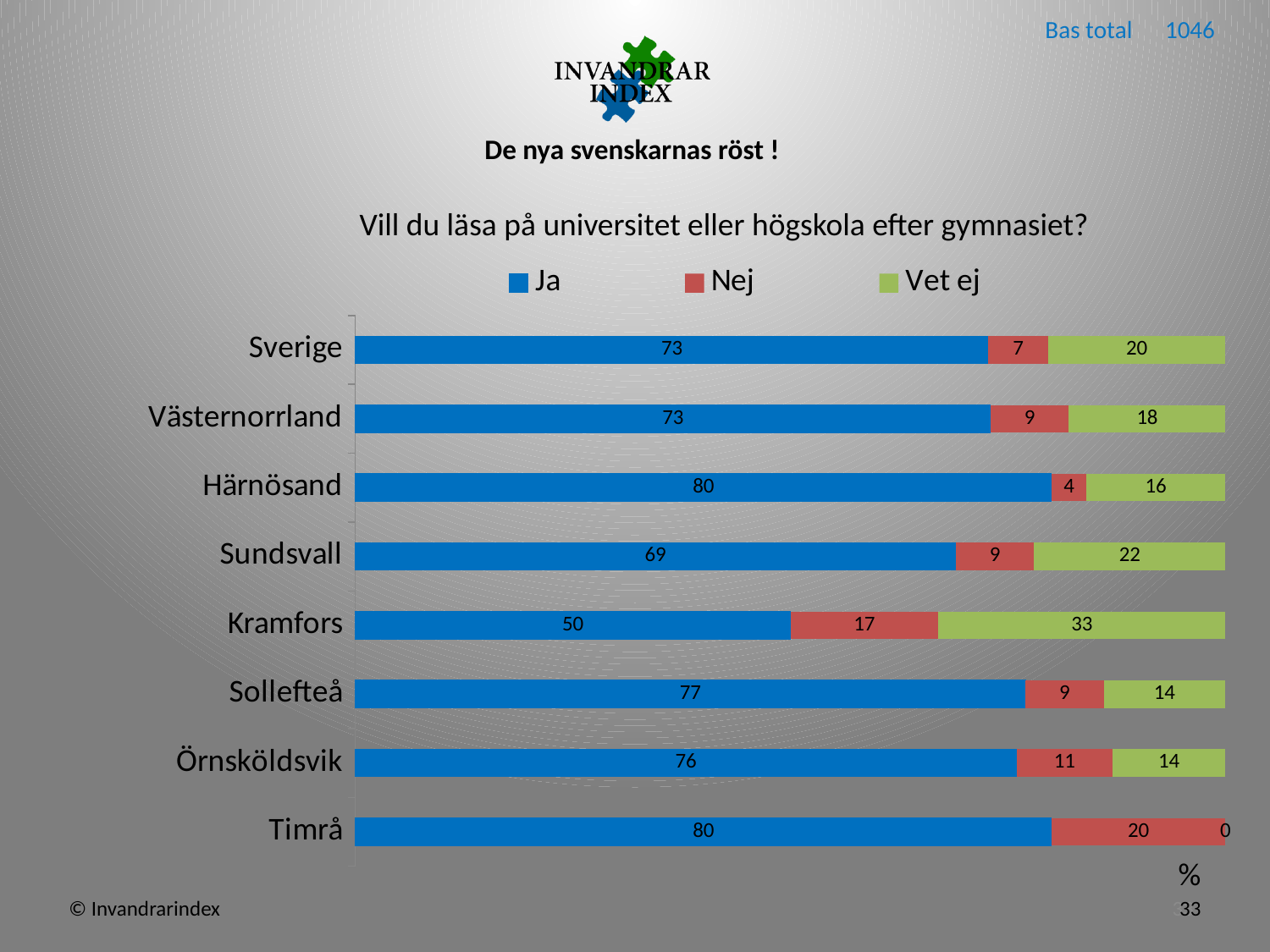
What is the "Vet ej" value for Sundsvall? 22 What is the difference between the "Ja" values for Härnösand and Sundsvall? 11 Which category has the lowest "Ja" value? Kramfors What is the "Ja" value for Kramfors? 50 What kind of chart is shown on the slide? Stacked bar chart Which has a larger "Nej" value, Örnsköldsvik or Härnösand? Örnsköldsvik What is the "Nej" value for Timrå? 20 What is the total of the stacked bar for Sollefteå? 100 Which category has the highest "Vet ej" value? Kramfors Which series is shown in green in the legend? Vet ej How many series does the legend list? 3 How many categories are shown on the chart? 8